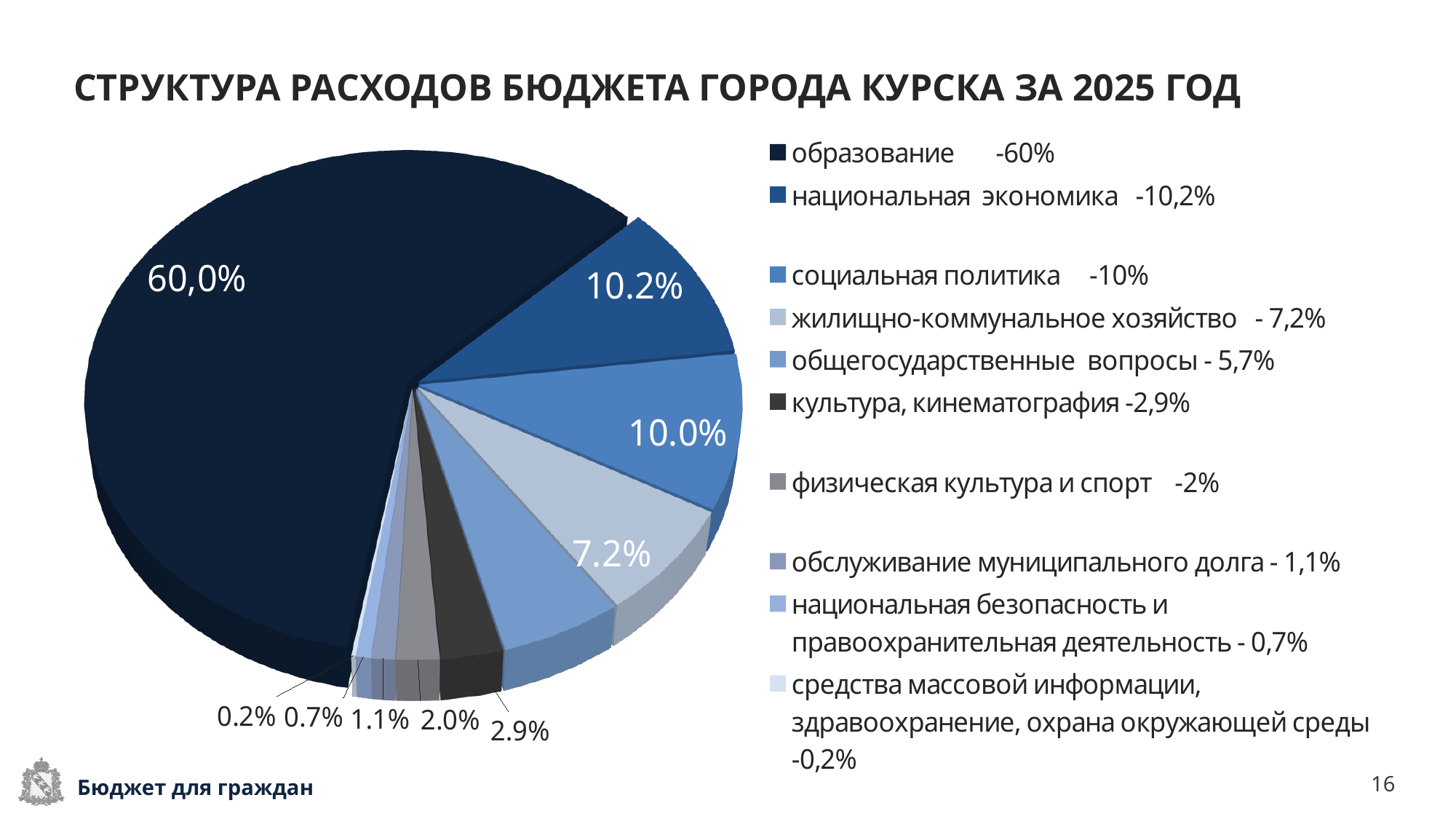
What is the value shown for жилищно-коммунальное хозяйство on the pie chart? 7.2% Which category has the largest slice of the pie chart? образование Which category has the smallest slice of the pie chart? средства массовой информации, здравоохранение, охрана окружающей среды What is the title of the slide's chart? СТРУКТУРА РАСХОДОВ БЮДЖЕТА ГОРОДА КУРСКА ЗА 2025 ГОД How many categories does the legend of the pie chart list? 10 What kind of chart is shown on the slide? pie chart Which is larger: the slice for жилищно-коммунальное хозяйство or the slice for культура, кинематография? жилищно-коммунальное хозяйство What share of the budget expenditure goes to образование according to the pie chart? 60,0% What is the value shown for культура, кинематография on the pie chart? 2.9% What is the difference in percentage points between the slices for образование and национальная экономика? 49.8% What is the value shown for физическая культура и спорт on the pie chart? 2.0% What is the value shown for национальная экономика on the pie chart? 10.2%